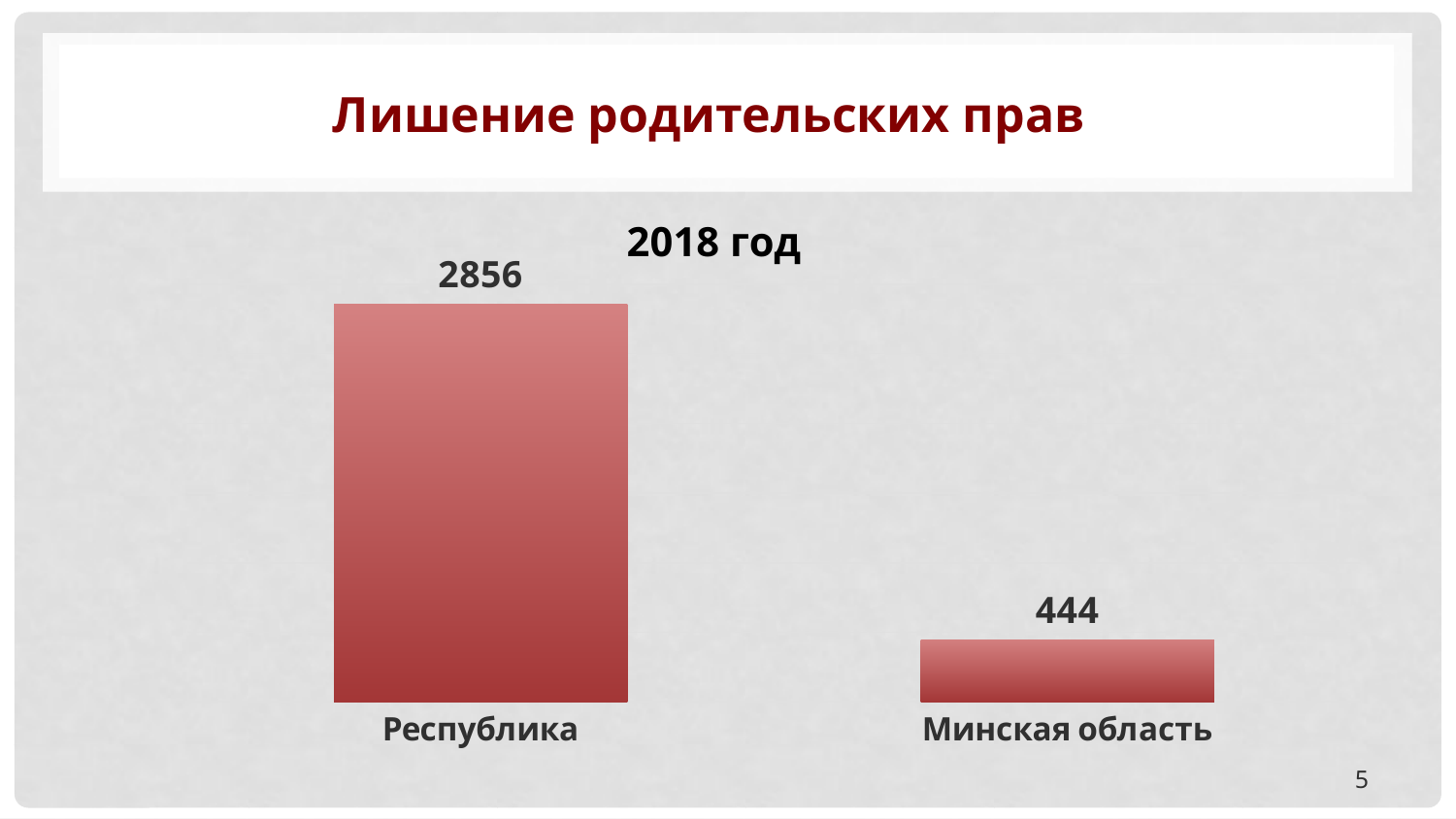
What is the value for Минская область? 444 What kind of chart is shown on the slide? Bar chart What is the value for Республика? 2856 Which is larger, the value for Республика or the value for Минская область? Республика What is the title of the slide? Лишение родительских прав What is the difference between the values for Республика and Минская область? 2412 What is the title of the chart? 2018 год How many categories are shown in the chart? 2 Which category has the highest value? Республика What is the total of the two values shown in the chart? 3300 Which category has the lowest value? Минская область